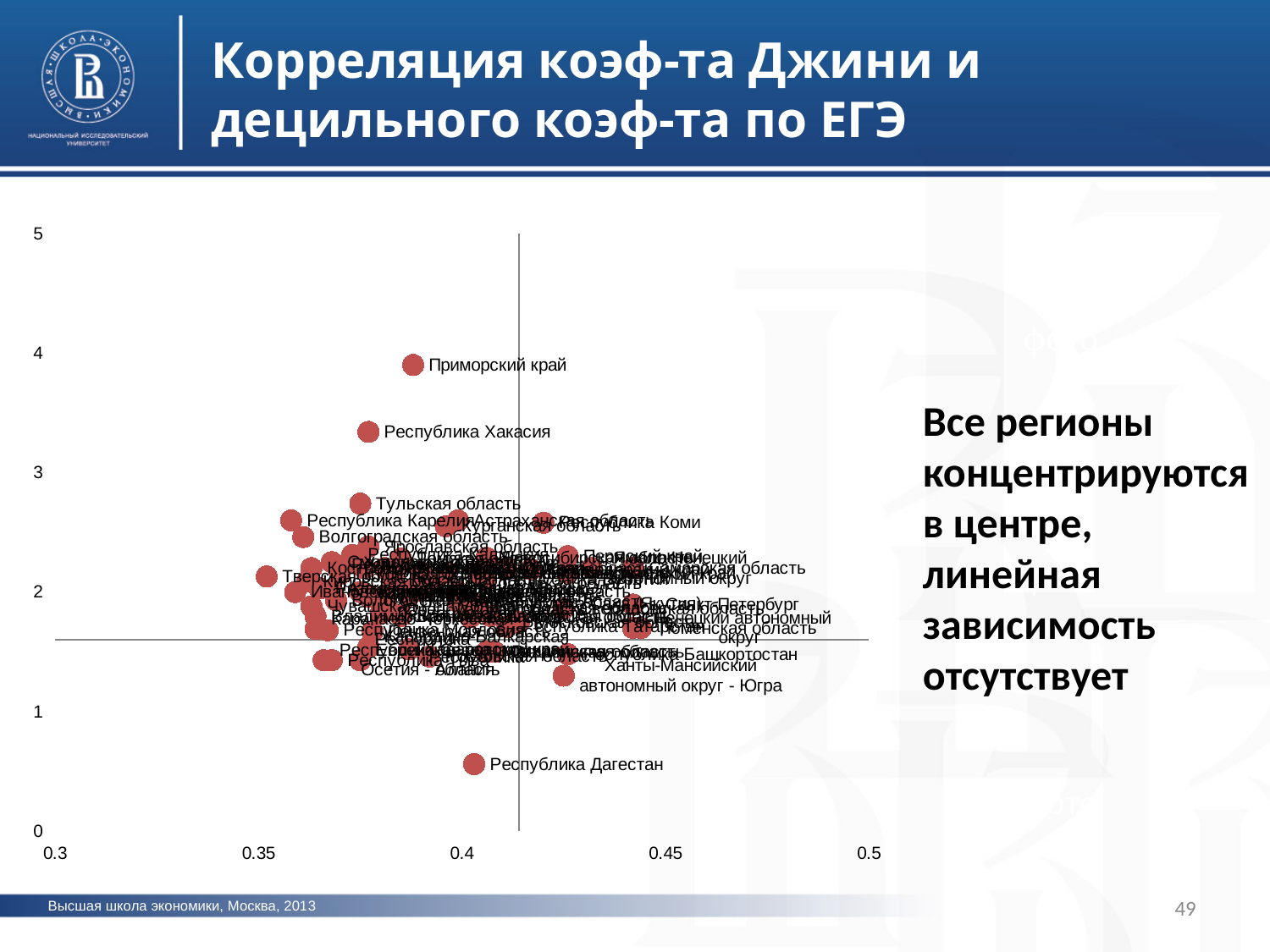
Is the horizontal-axis value for Приморский край greater or less than 0.4? less What is the title of the slide containing the chart? Корреляция коэф-та Джини и децильного коэф-та по ЕГЭ Which labelled region has the highest value on the vertical axis? Приморский край Which point is higher on the vertical axis, Приморский край or Республика Хакасия? Приморский край What kind of chart is shown on the slide? scatter plot Is the horizontal-axis value for Ханты-Мансийский автономный округ - Югра greater or less than 0.4? greater Is the vertical-axis value for Республика Хакасия greater or less than 3? greater Which point is higher on the vertical axis, Республика Дагестан or Ханты-Мансийский автономный округ - Югра? Ханты-Мансийский автономный округ - Югра Which labelled region has the lowest value on the vertical axis? Республика Дагестан